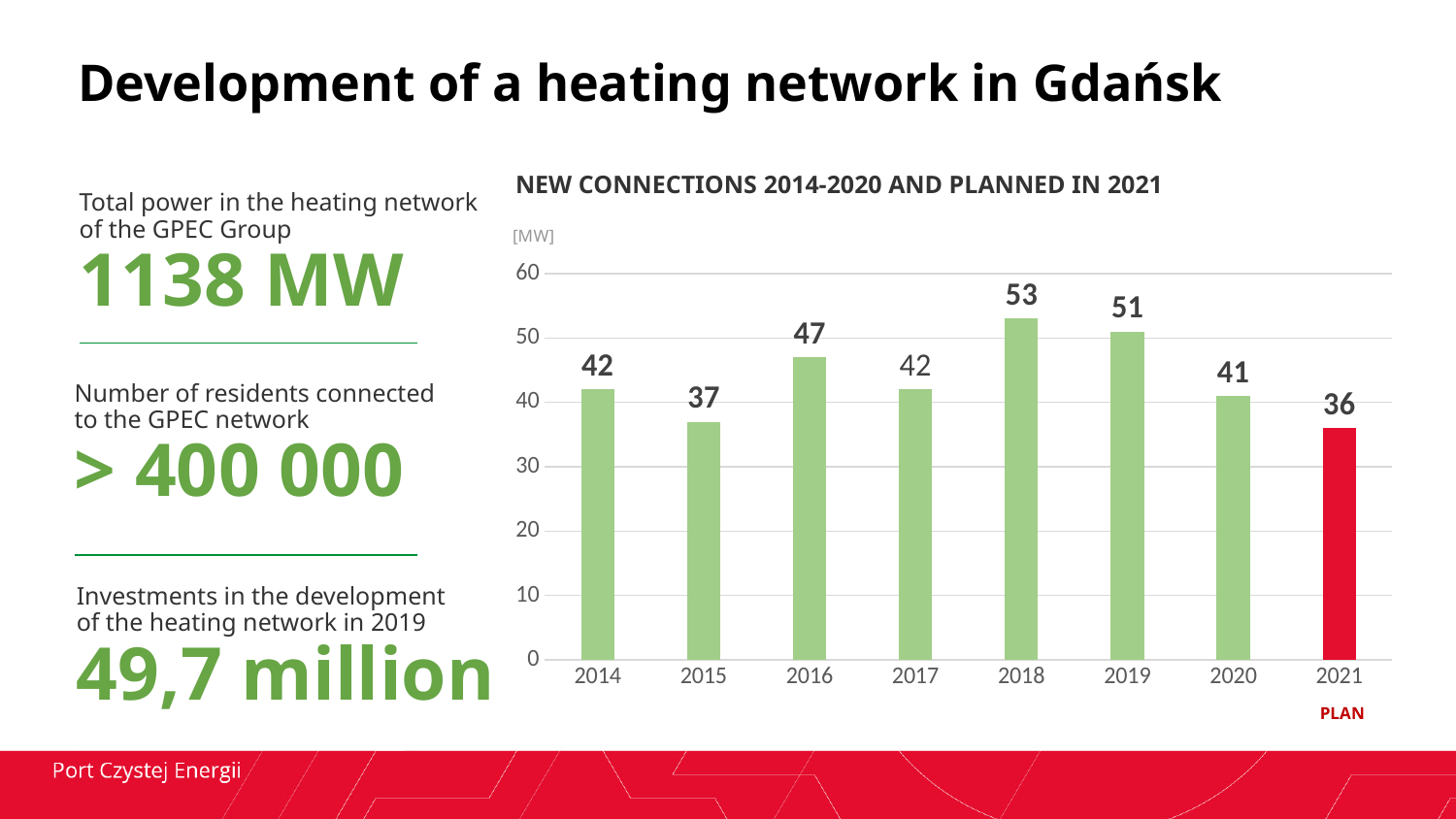
What unit is shown on the chart's y axis? [MW] What kind of chart is shown on the slide? bar chart What is the title of the chart? NEW CONNECTIONS 2014-2020 AND PLANNED IN 2021 What is the value for 2015 in the chart? 37 What is the planned value for 2021 in the chart? 36 What is the difference between the values for 2018 and 2015? 16 Which year has the highest value in the chart? 2018 What is the value for 2018 in the chart? 53 How many years are shown on the x axis of the chart? 8 Which year has the lowest value in the chart? 2021 Which is larger, the value for 2016 or the value for 2019? 2019 Is the value for 2020 greater or less than 50? less